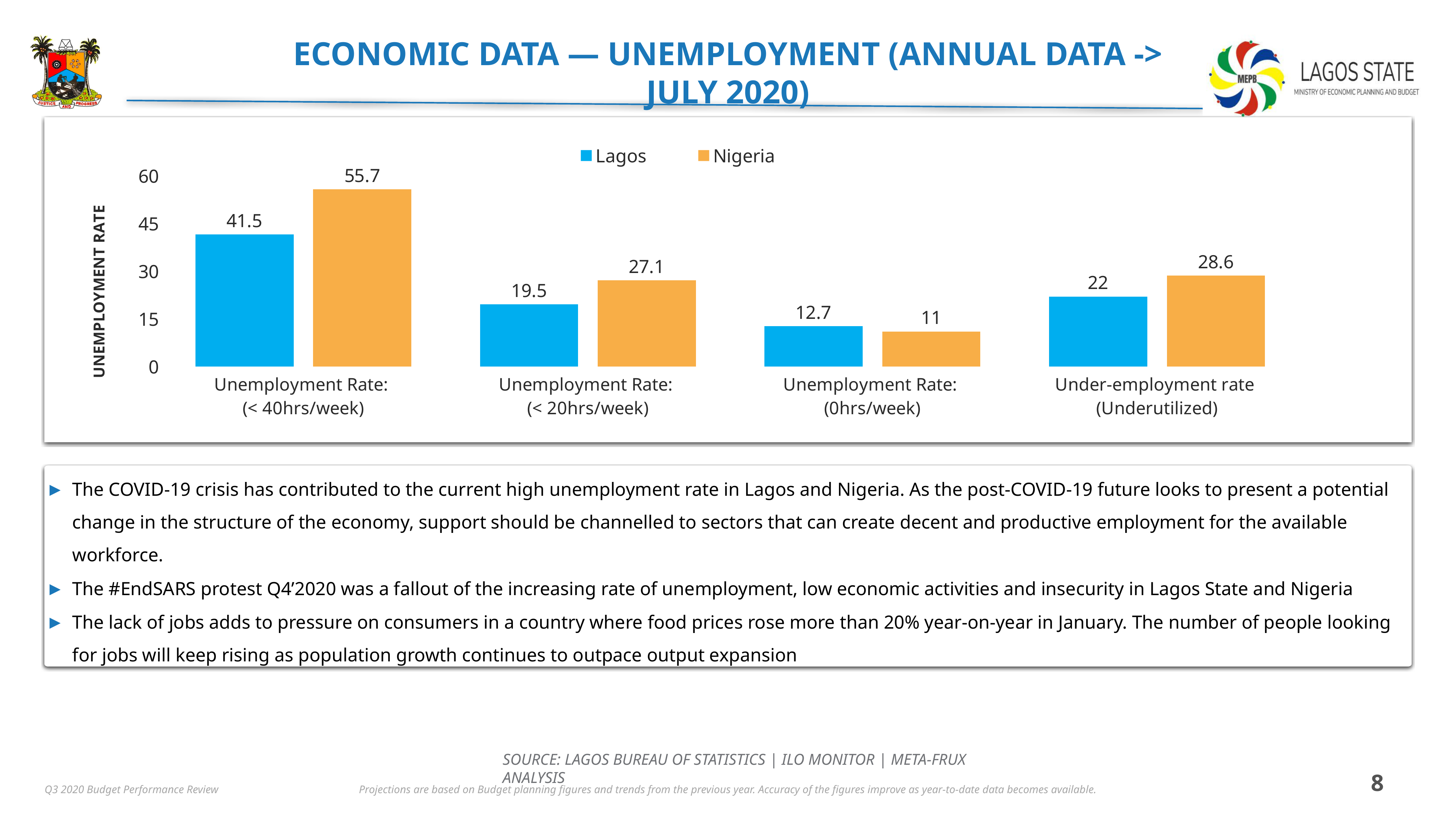
What is the Lagos value for Unemployment Rate: (0hrs/week)? 12.7 What is the Nigeria value for Under-employment rate (Underutilized)? 28.6 What is the Lagos value for Unemployment Rate: (< 40hrs/week)? 41.5 What is the difference between the Nigeria and Lagos values for Unemployment Rate: (< 40hrs/week)? 14.2 How many categories are shown on the x axis? 4 What kind of chart is shown on the slide? Bar chart Which category has the highest Nigeria value? Unemployment Rate: (< 40hrs/week) How many series does the legend list? 2 For Unemployment Rate: (0hrs/week), which is larger, Lagos or Nigeria? Lagos Is the Lagos value for Under-employment rate (Underutilized) greater or less than 30? less Which category has the lowest Lagos value? Unemployment Rate: (0hrs/week) What is the Nigeria value for Unemployment Rate: (< 20hrs/week)? 27.1